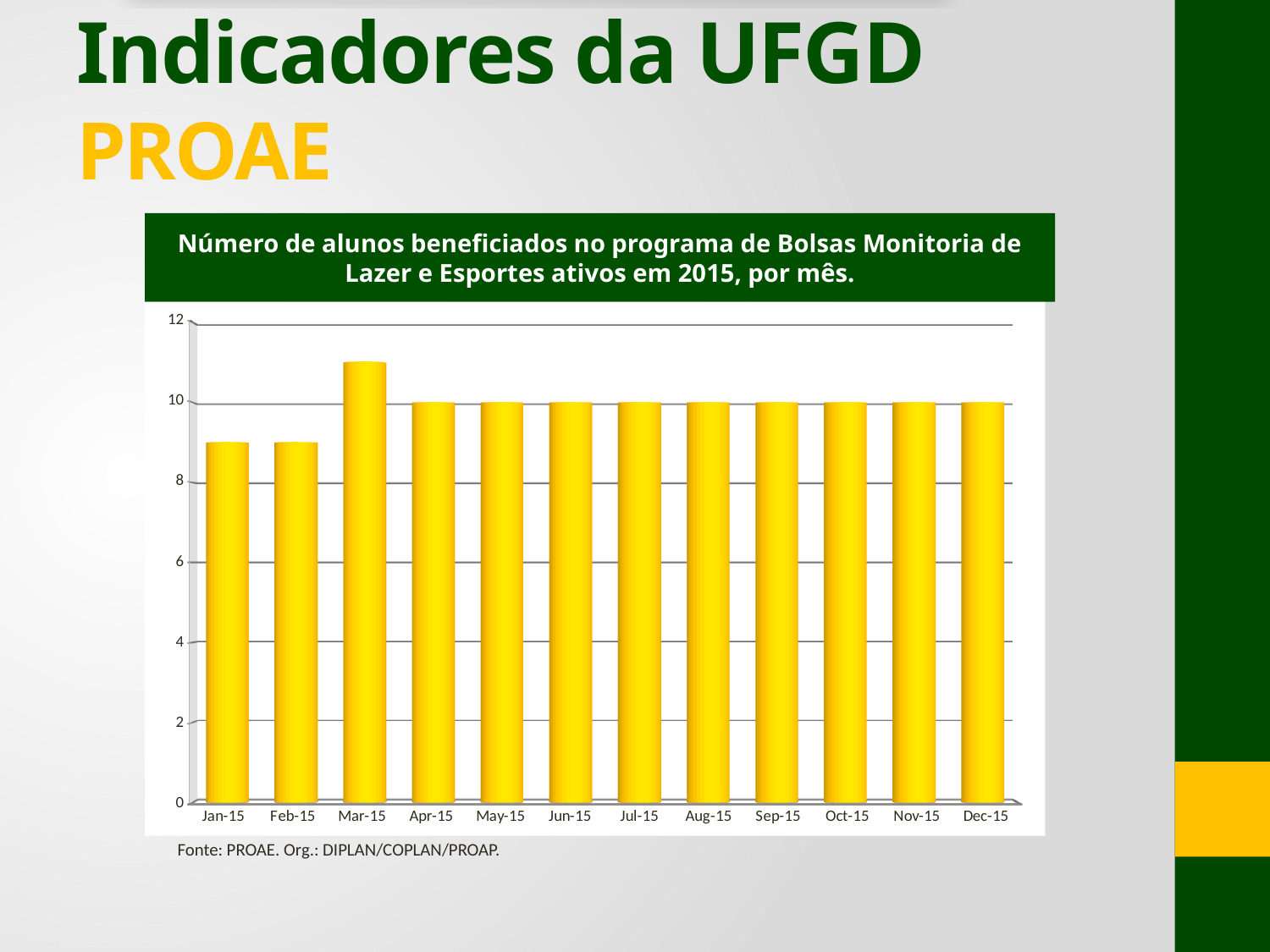
Is the value for Feb-15 greater or less than 8? greater What is the value for Dec-15 in the chart? 10 Is the value for Mar-15 greater or less than 10? greater How many months are plotted on the x axis of the chart? 12 Is the value for Jan-15 greater or less than 10? less What is the source cited below the chart? Fonte: PROAE. Org.: DIPLAN/COPLAN/PROAP. What is the value for Apr-15 in the chart? 10 Which is larger, the value for Mar-15 or the value for Apr-15? Mar-15 What kind of chart is shown on the slide? bar chart Which month has the highest number of beneficiaries in the chart? Mar-15 Which is larger, the value for Jan-15 or the value for Jun-15? Jun-15 Do the values rise or fall from Feb-15 to Mar-15? rise